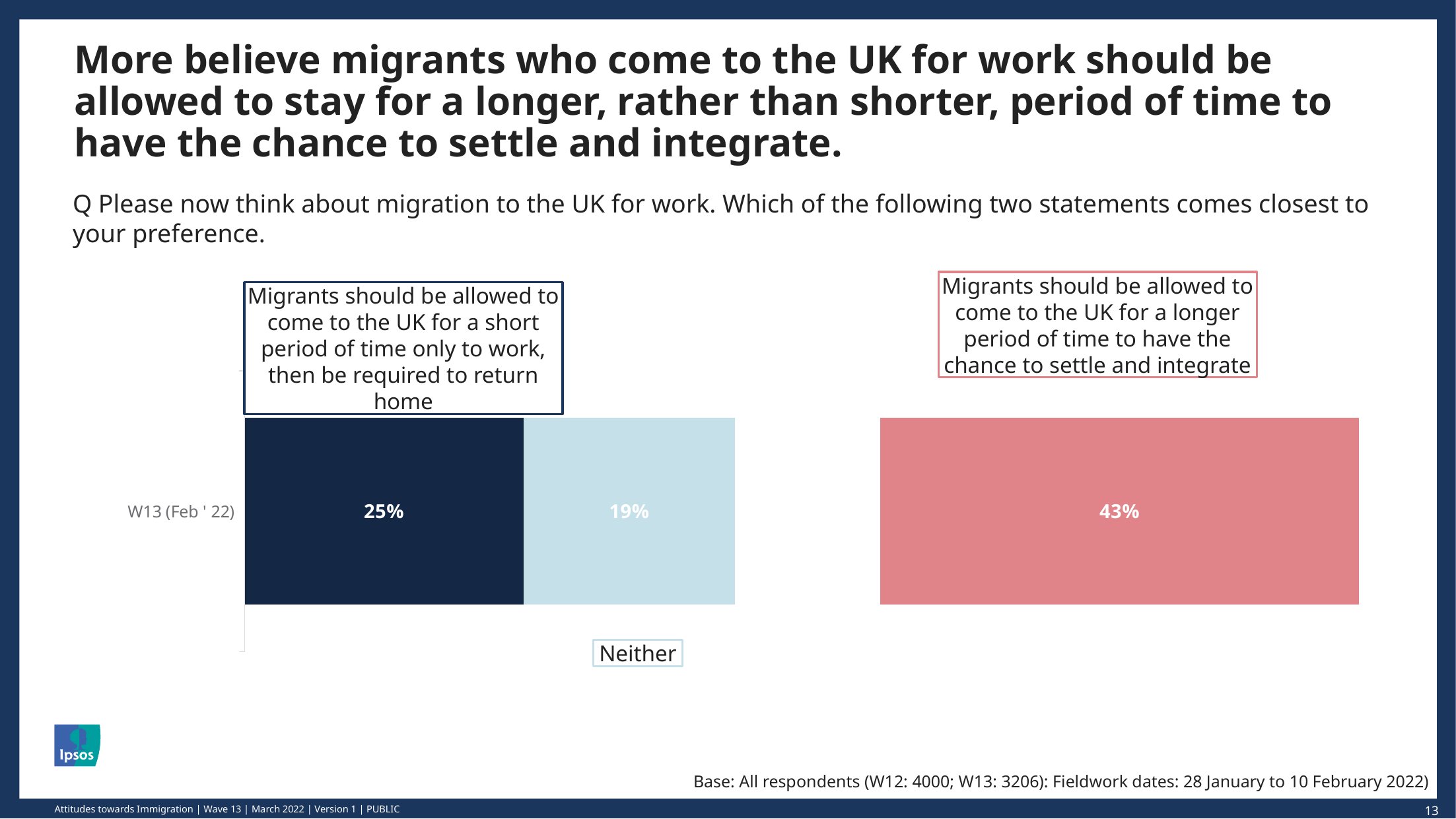
Which response option has the lowest percentage? Neither How many response options are shown in the bar? 3 What percentage of respondents said migrants should be allowed to come to the UK for a longer period of time to have the chance to settle and integrate? 43% What percentage of respondents said migrants should be allowed to come to the UK for a short period of time only to work, then be required to return home? 25% Which wave is shown on the chart's category axis? W13 (Feb ' 22) What percentage of respondents chose 'Neither'? 19% Which response option has the highest percentage? Migrants should be allowed to come to the UK for a longer period of time to have the chance to settle and integrate What is the difference in percentage points between the short period option and 'Neither'? 6 percentage points What colour is the segment for the longer period of time option? Red/pink What is the difference in percentage points between those preferring a longer period and those preferring a short period? 18 percentage points What kind of chart is shown on the slide? Stacked bar chart Which is larger: the share preferring a short period of time or the share choosing 'Neither'? Short period of time